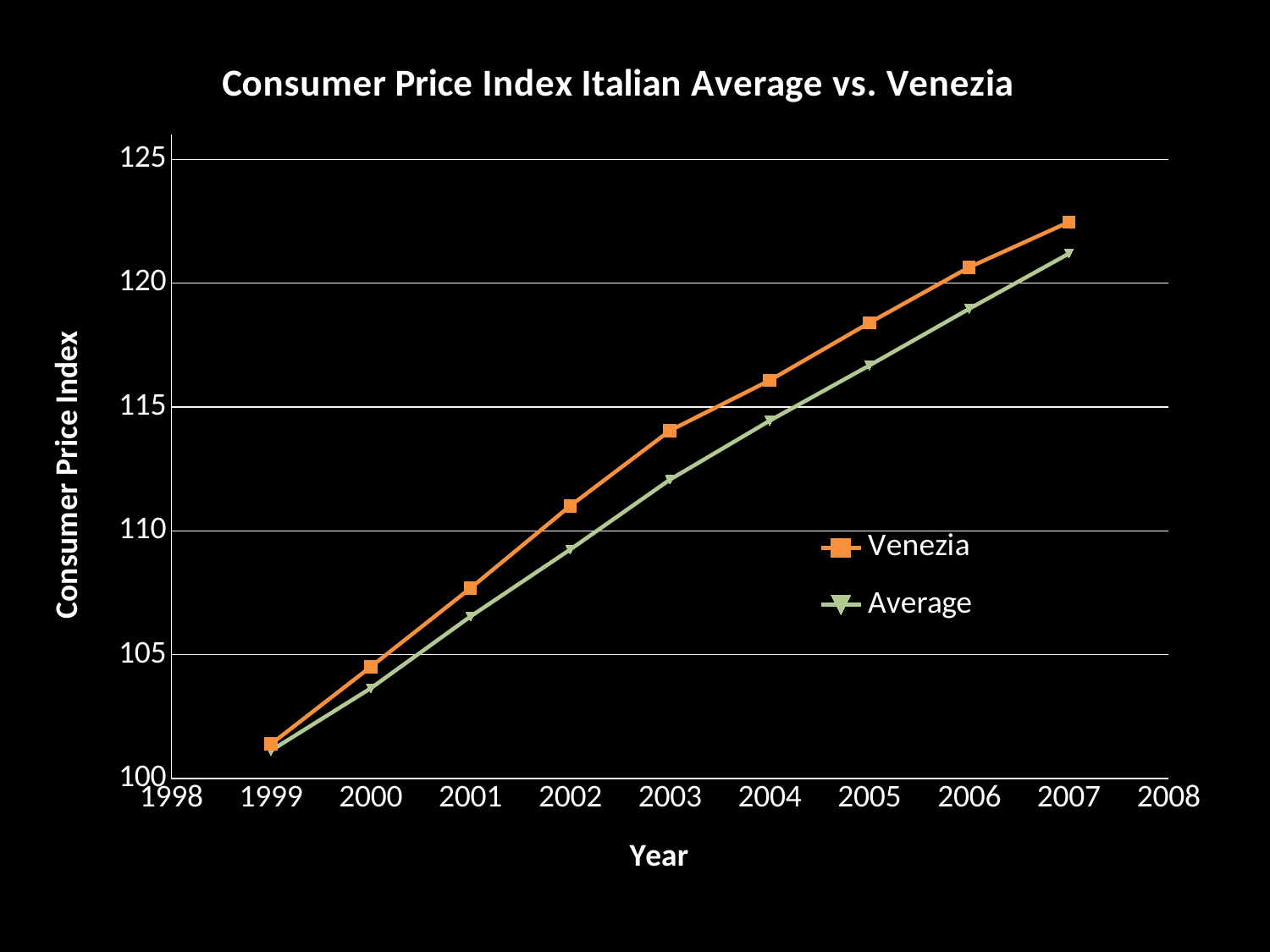
What kind of chart is shown on the slide? line chart Is the value for Venezia in 2006 greater or less than 120? greater In 2003, which series has the larger value, Venezia or Average? Venezia In which year is the Venezia value highest? 2007 Is the value for Average in 2004 greater or less than 115? less How many data points are plotted for the Venezia series? 9 How many series does the legend list? 2 Is the value for Average in 2001 greater or less than 105? greater What is the title of the chart? Consumer Price Index Italian Average vs. Venezia What is the label of the x axis? Year Do the Venezia values rise or fall from 1999 to 2007? rise In which year is the Average value lowest? 1999